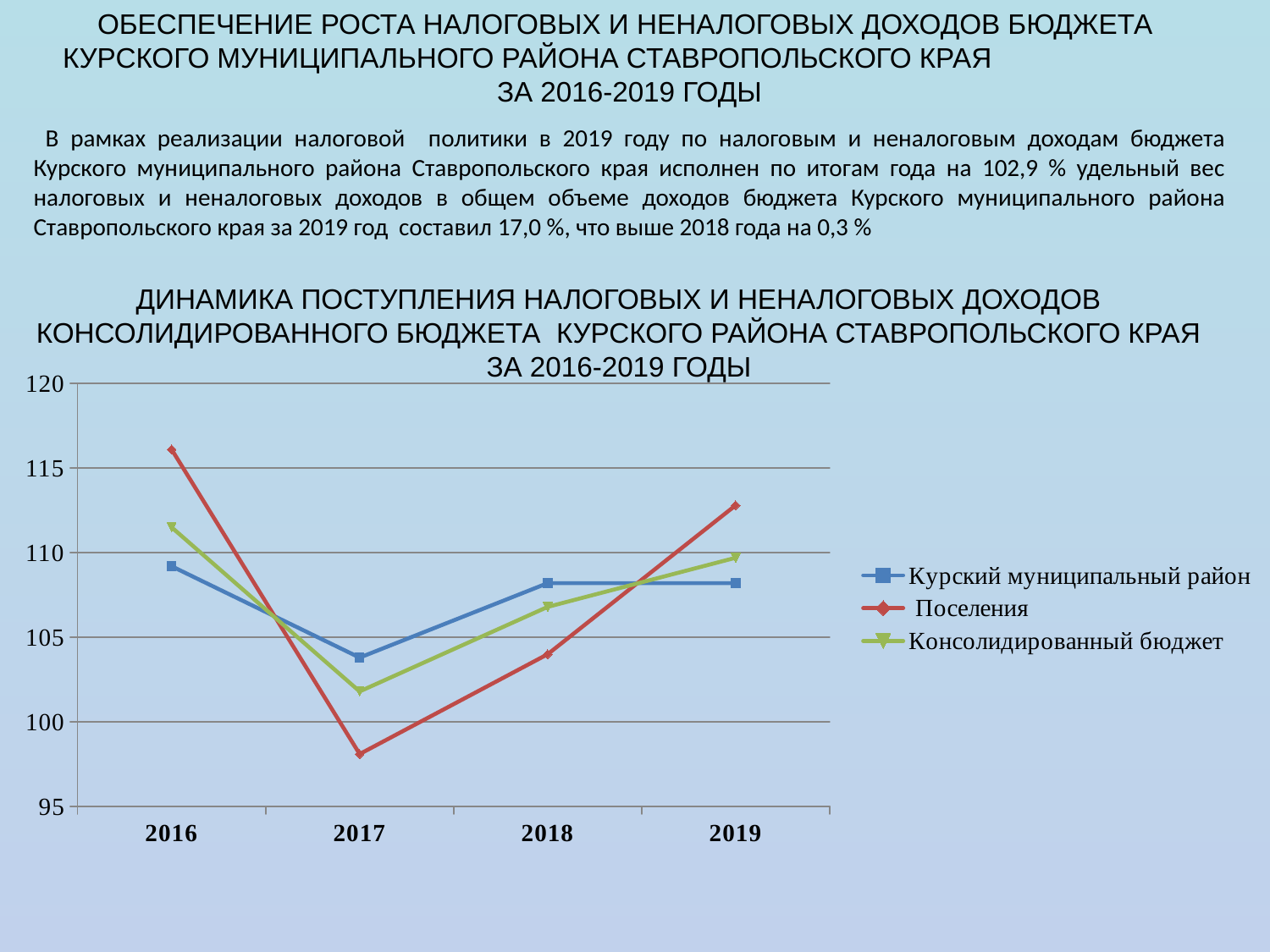
In which year is the value for Курский муниципальный район lowest? 2017 In which year is the value for Поселения highest? 2016 What kind of chart is shown on the slide? line chart Does the value for Поселения rise or fall from 2017 to 2019? rise In 2016, which series has the larger value: Поселения or Курский муниципальный район? Поселения Is the value for Поселения in 2016 greater or less than 115? greater How many years are plotted along the x axis of the chart? 4 How many series does the chart legend list? 3 In 2017, which series has the larger value: Курский муниципальный район or Поселения? Курский муниципальный район In which year is the value for Поселения lowest? 2017 Is the value for Консолидированный бюджет in 2019 greater or less than 105? greater Is the value for Поселения in 2017 greater or less than 100? less